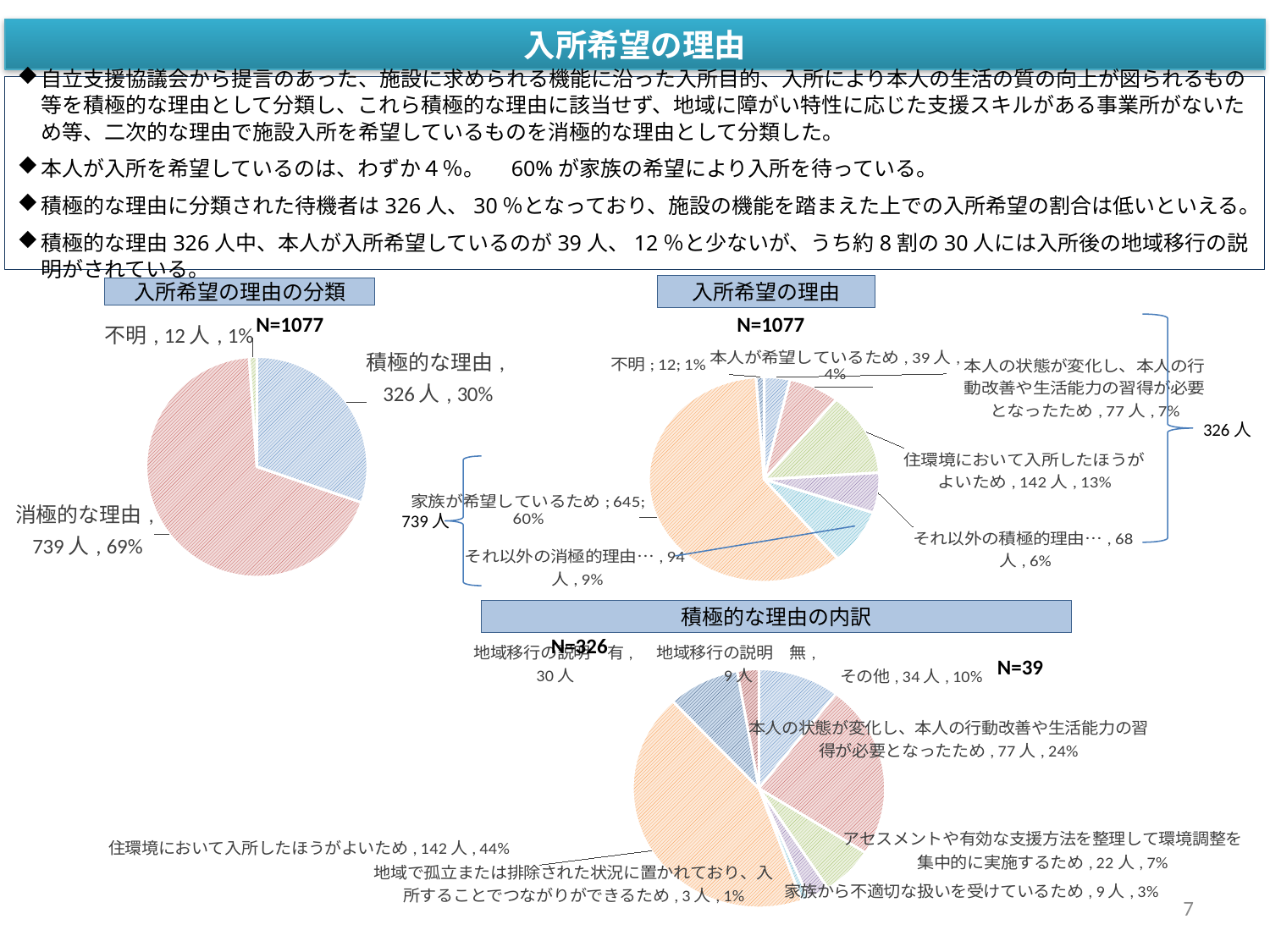
In the chart titled 入所希望の理由の分類, how many people are in the 積極的な理由 category? 326人 In the chart titled 入所希望の理由の分類, what percentage is 消極的な理由? 69% In the chart titled 積極的な理由の内訳, what percentage is 住環境において入所したほうがよいため? 44% In the chart titled 入所希望の理由, what is the N value shown? N=1077 In the chart titled 積極的な理由の内訳, how many people are in the アセスメントや有効な支援方法を整理して環境調整を集中的に実施するため category? 22人 In the chart titled 入所希望の理由, what percentage is 家族が希望しているため? 60% In the chart titled 入所希望の理由の分類, what is the difference in number of people between 消極的な理由 and 積極的な理由? 413人 In the chart titled 入所希望の理由, which is larger: 本人が希望しているため or それ以外の積極的理由? それ以外の積極的理由 In the chart titled 入所希望の理由, how many people are in the 住環境において入所したほうがよいため category? 142人 What kind of chart is the one titled 入所希望の理由の分類? Pie chart In the chart titled 入所希望の理由の分類, which category has the smallest share? 不明 In the chart titled 入所希望の理由の分類, which category has the largest share? 消極的な理由